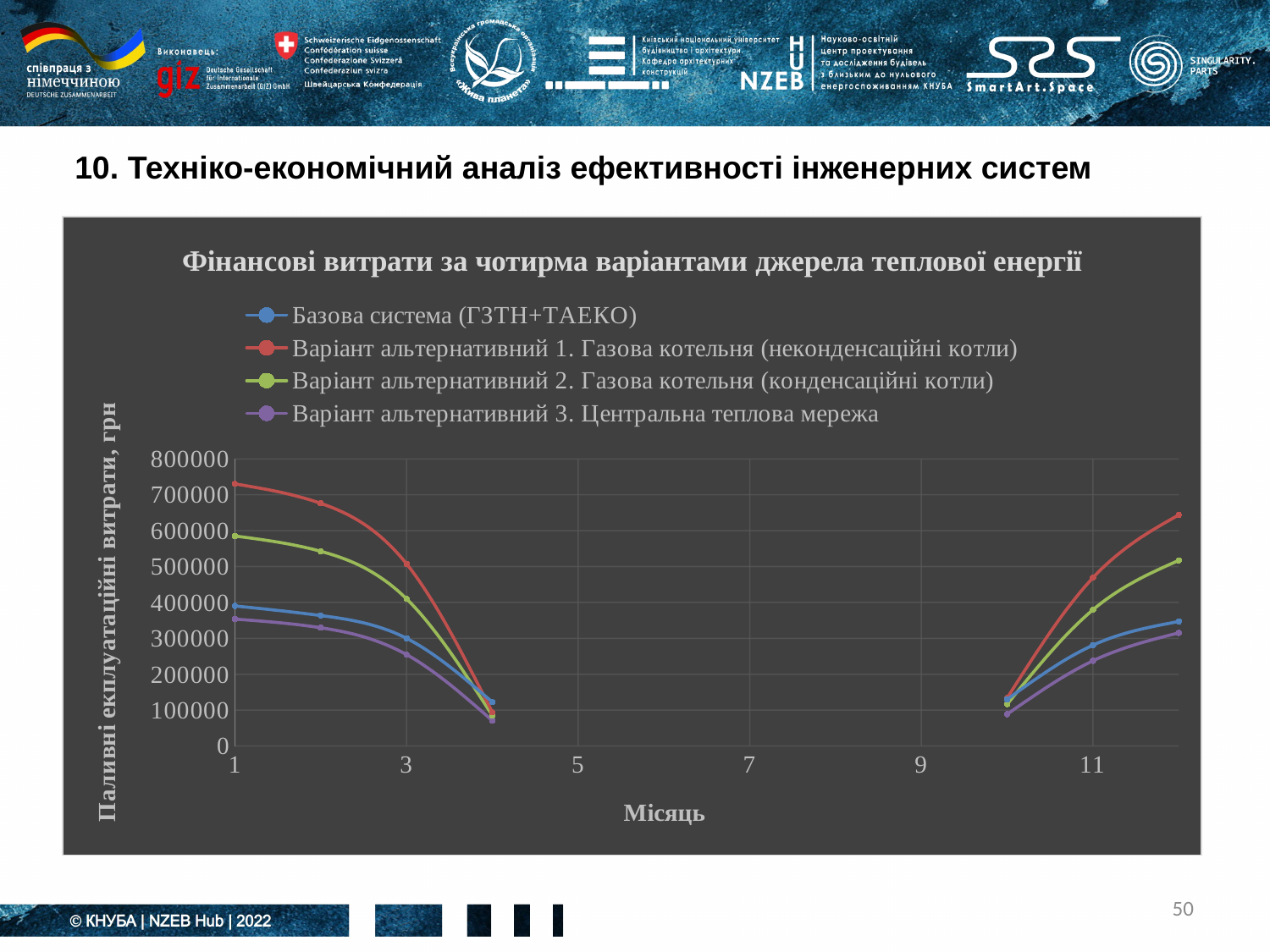
How many series does the legend list? 4 Is the value for Базова система at month 4 greater or less than 200000? less Do the values for Варіант альтернативний 1 rise or fall from month 1 to month 4? fall Which series has the lowest value at month 1? Варіант альтернативний 3. Центральна теплова мережа Is the value for Варіант альтернативний 3 at month 12 greater or less than 400000? less Which series has the highest value at month 1? Варіант альтернативний 1. Газова котельня (неконденсаційні котли) At month 12, which is larger: Варіант альтернативний 1 or Варіант альтернативний 2? Варіант альтернативний 1 Is the value for Варіант альтернативний 2 at month 1 greater or less than 500000? greater What is the label of the x axis? Місяць What is the title of the chart? Фінансові витрати за чотирма варіантами джерела теплової енергії What kind of chart is shown on the slide? line chart